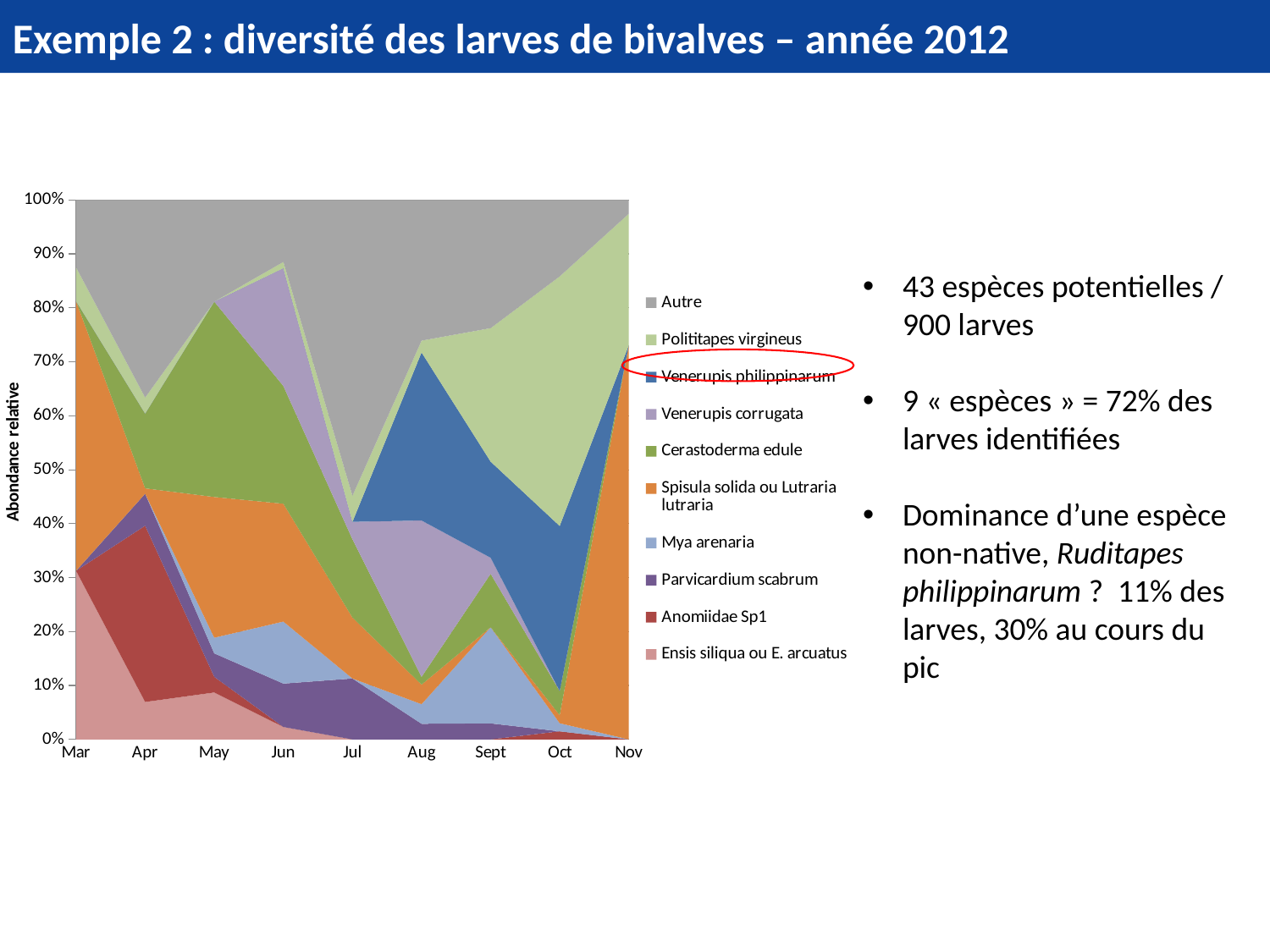
Which month is the first category on the x axis of the chart? Mar What kind of chart is shown on the slide? Stacked area chart How many series does the chart legend list? 10 Is the share of Autre in Jul greater or less than 50%? greater Which month is the last category on the x axis of the chart? Nov Is the share of Autre in Nov greater or less than 10%? less Which legend entry is circled in red on the chart? Venerupis philippinarum Does the share of Autre rise or fall from Jul to Nov? fall Is the value for Ensis siliqua ou E. arcuatus in Apr greater or less than 10%? less How many months are shown along the x axis of the chart? 9 What is the title of the y axis of the chart? Abondance relative